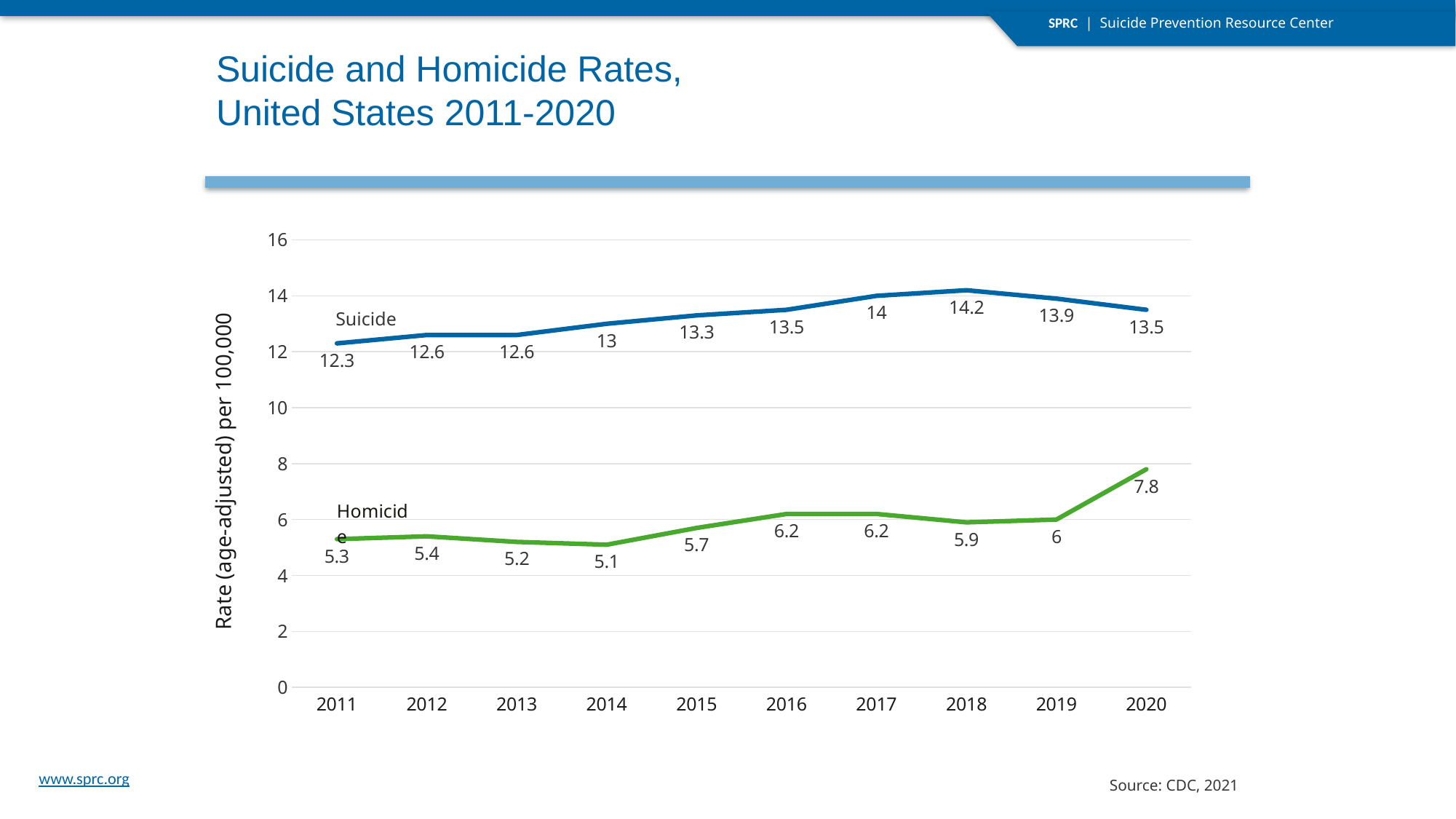
In which year was the suicide rate highest? 2018 What is the label of the y axis? Rate (age-adjusted) per 100,000 Which was higher in 2016, the suicide rate or the homicide rate? Suicide rate By how much did the homicide rate increase from 2019 to 2020? 1.8 What was the suicide rate in 2011? 12.3 What is the difference between the suicide rate and the homicide rate in 2020? 5.7 What was the suicide rate in 2018? 14.2 What was the homicide rate in 2020? 7.8 In which year was the homicide rate lowest? 2014 Is the suicide rate in 2017 greater or less than 12? greater What type of chart is shown on the slide? Line chart How many years are shown on the x axis? 10